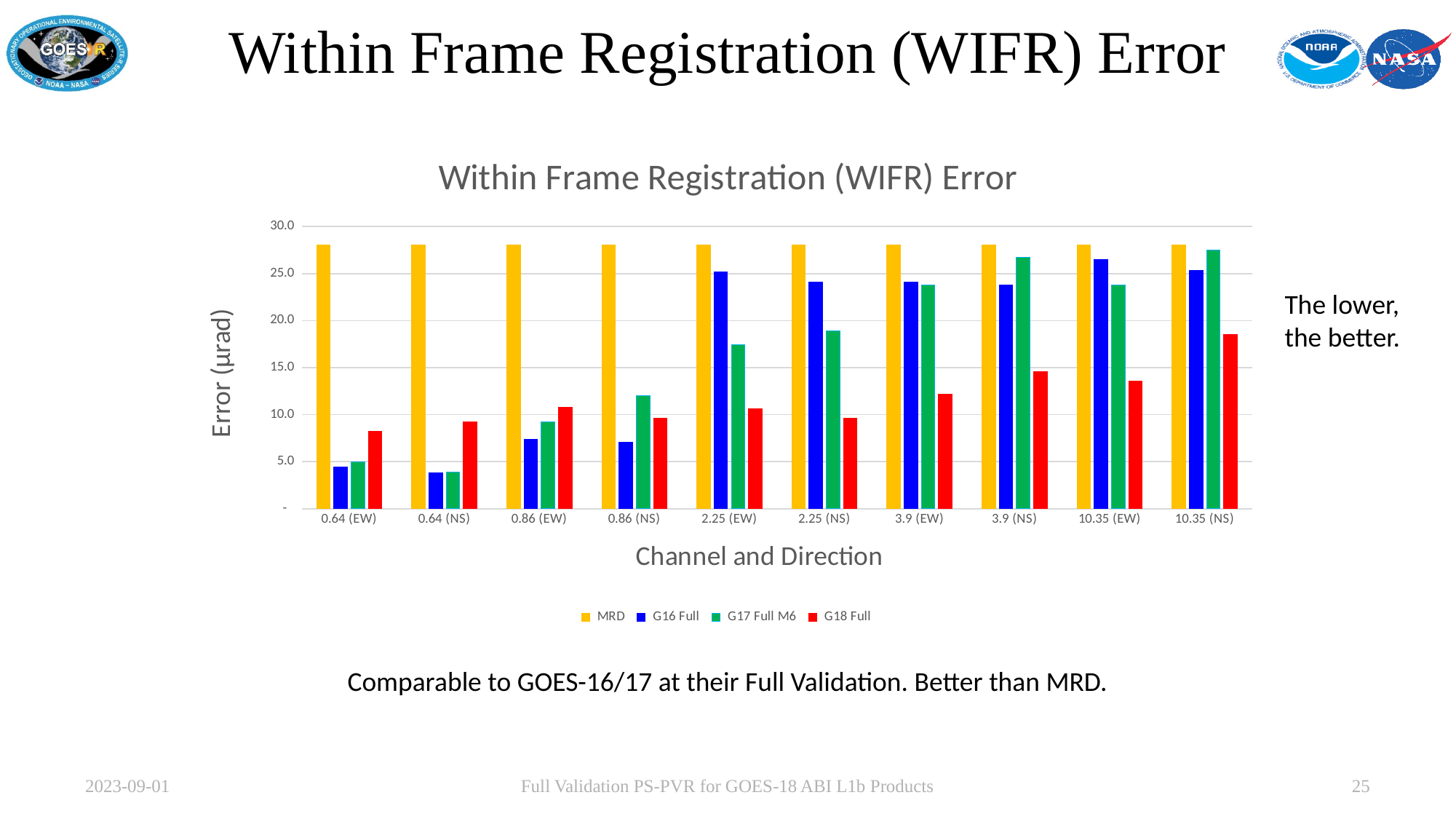
Is the G18 Full value for 10.35 (NS) greater or less than 15.0? greater Is the G17 Full M6 value for 0.64 (EW) greater or less than 10.0? less How many channel-and-direction categories are shown on the x axis? 10 For 2.25 (EW), which is larger: G16 Full or G18 Full? G16 Full What is the title of the x axis? Channel and Direction Which category has the highest G18 Full value? 10.35 (NS) For 0.86 (NS), which is larger: G17 Full M6 or G16 Full? G17 Full M6 Is the G16 Full value for 2.25 (EW) greater or less than 20.0? greater What is the title of the y axis? Error (µrad) How many series does the legend list? 4 What kind of chart is shown on the slide? bar chart